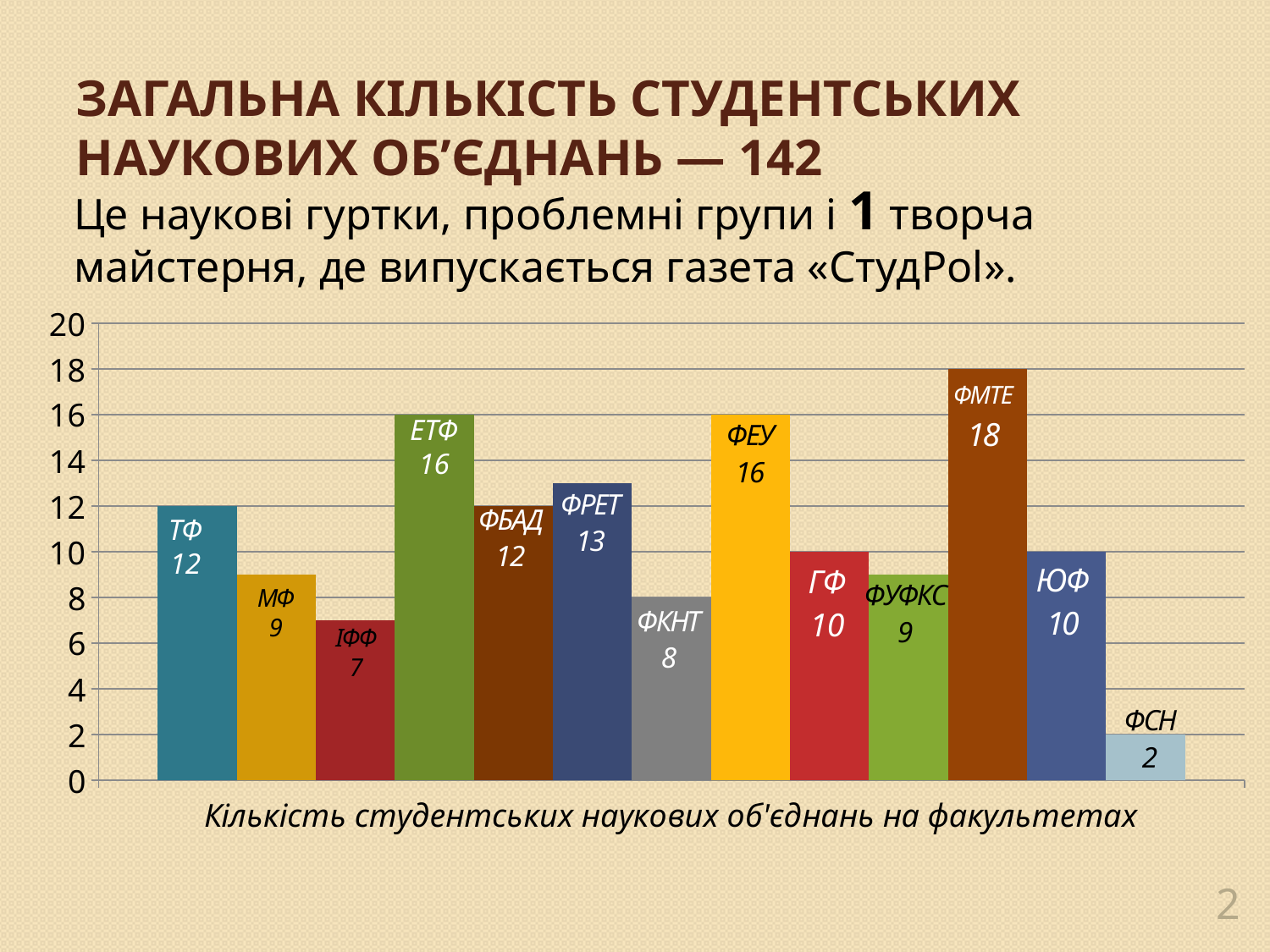
What is the difference between the values for ФМТЕ and ФСН? 16 Is the value for ФЕУ greater or less than 14? greater What is the value for ФСН? 2 Which is larger, the value for ЕТФ or the value for ФБАД? ЕТФ What is the value for ФМТЕ? 18 What type of chart is shown on the slide? bar chart How many faculties (bars) are shown in the chart? 13 What is the difference between the values for ФРЕТ and ІФФ? 6 Which faculty has the highest number of student scientific associations? ФМТЕ Which faculty has the lowest number of student scientific associations? ФСН What is the value for ФКНТ? 8 What is the caption shown below the chart? Кількість студентських наукових об'єднань на факультетах